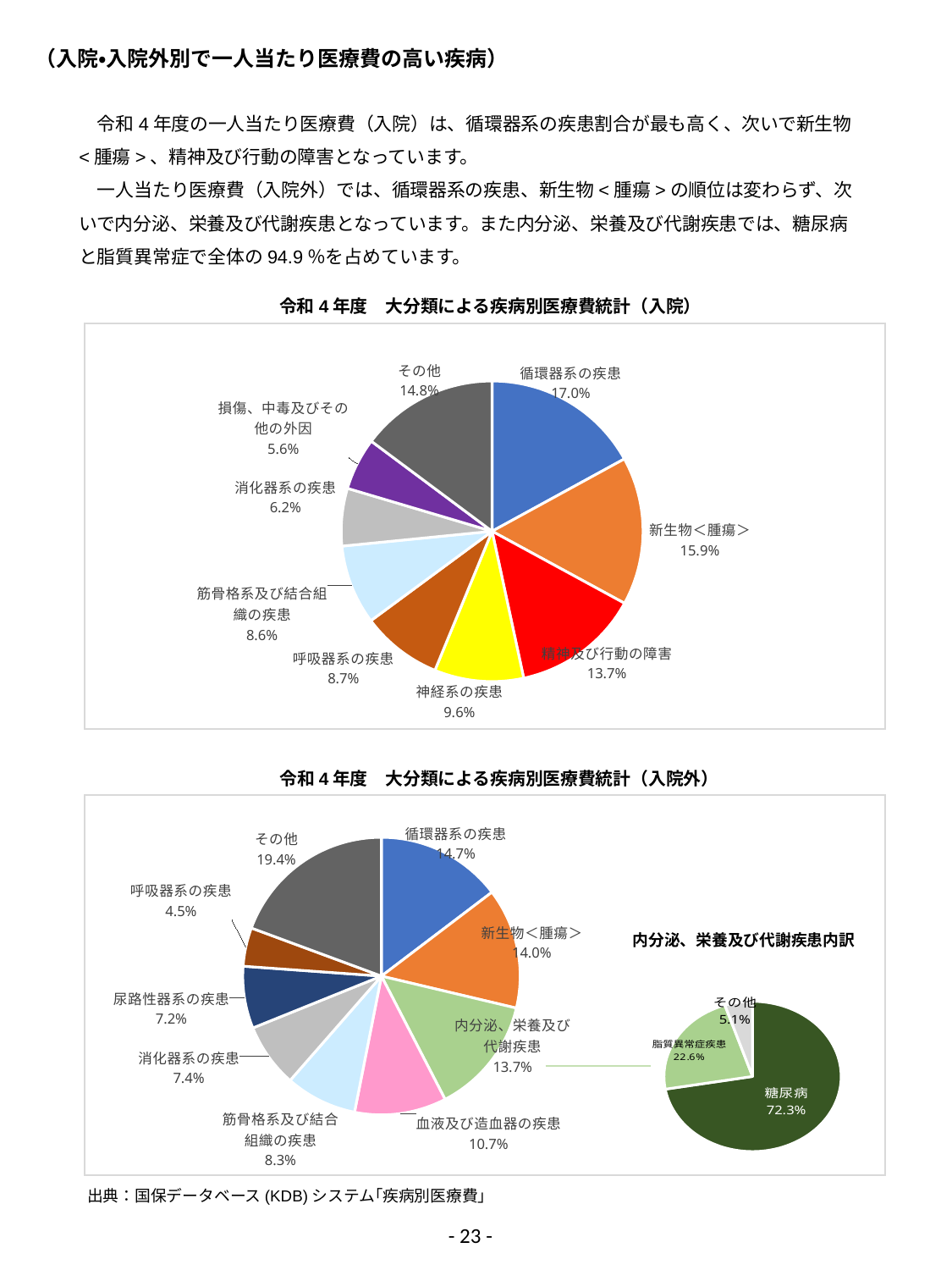
In the 内分泌、栄養及び代謝疾患内訳 sub-pie of the 入院外 chart, what is the combined share of 糖尿病 and 脂質異常症? 94.9% In the chart titled 令和4年度 大分類による疾病別医療費統計（入院）, what is the difference in percentage points between 循環器系の疾患 and 新生物＜腫瘍＞? 1.1 In the chart titled 令和4年度 大分類による疾病別医療費統計（入院外）, what share does 内分泌、栄養及び代謝疾患 have? 13.7% In the chart titled 令和4年度 大分類による疾病別医療費統計（入院外）, which is larger, 消化器系の疾患 or 尿路性器系の疾患? 消化器系の疾患 In the chart titled 令和4年度 大分類による疾病別医療費統計（入院）, which named disease category (excluding その他) has the largest share? 循環器系の疾患 In the chart titled 令和4年度 大分類による疾病別医療費統計（入院）, what share does 精神及び行動の障害 have? 13.7% In the chart titled 令和4年度 大分類による疾病別医療費統計（入院）, how many slices does the pie have? 9 In the 内分泌、栄養及び代謝疾患内訳 sub-pie of the 入院外 chart, what share does 糖尿病 have? 72.3% In the chart titled 令和4年度 大分類による疾病別医療費統計（入院外）, which category has the smallest share? 呼吸器系の疾患 In the chart titled 令和4年度 大分類による疾病別医療費統計（入院）, which category has the smallest share? 損傷、中毒及びその他の外因 In the chart titled 令和4年度 大分類による疾病別医療費統計（入院）, what share does 循環器系の疾患 have? 17.0% What kind of chart is 令和4年度 大分類による疾病別医療費統計（入院外）? Pie chart